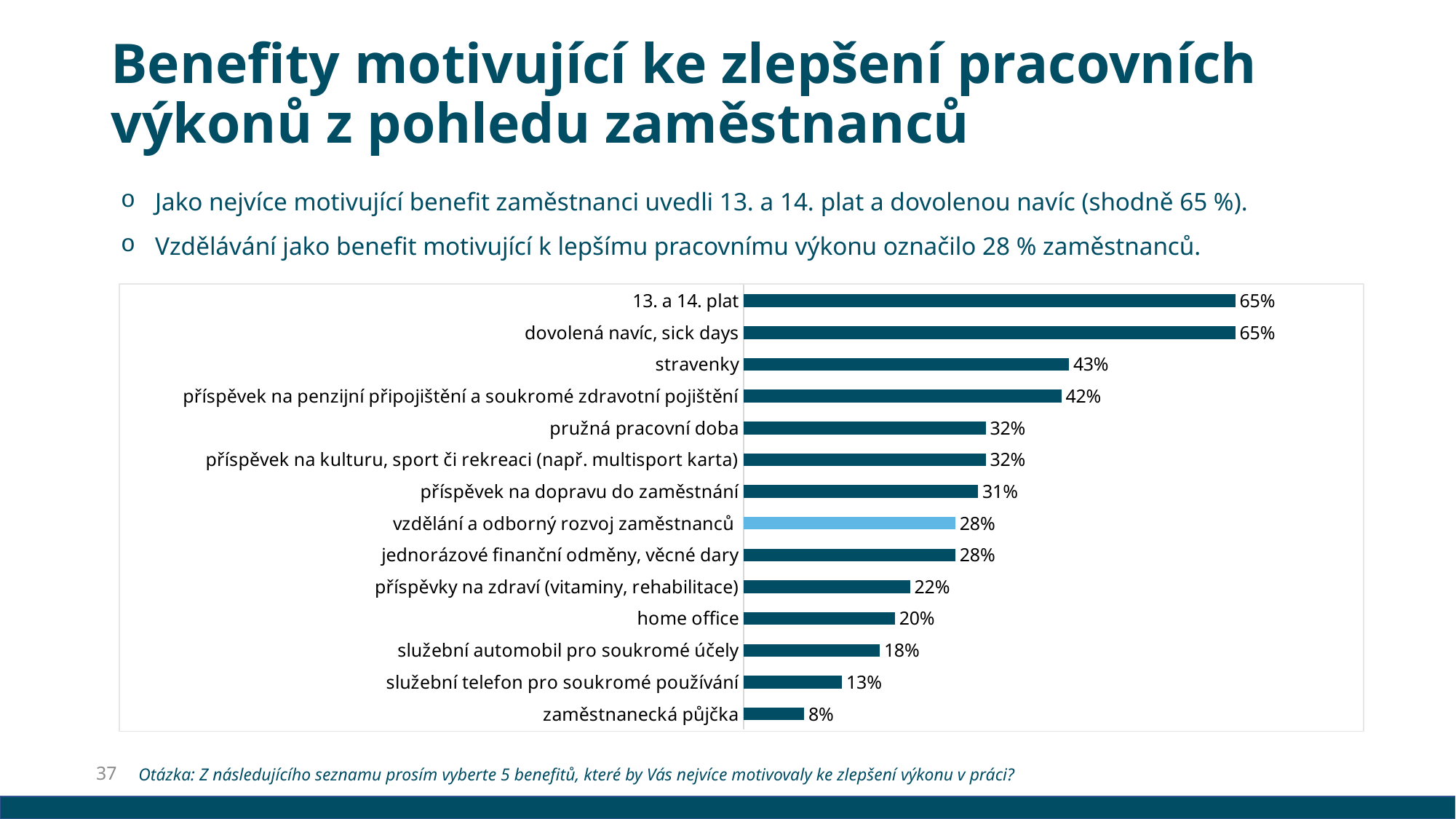
What is the highest value shown in the chart? 65% What is the value for "home office"? 20% What kind of chart is shown on the slide? bar chart Which bar is highlighted in a lighter blue colour than the others? vzdělání a odborný rozvoj zaměstnanců What is the value for "vzdělání a odborný rozvoj zaměstnanců"? 28% What is the value for "stravenky"? 43% What is the value for "služební telefon pro soukromé používání"? 13% What is the difference between the values for "stravenky" and "home office"? 23% Which is larger, the value for "příspěvek na dopravu do zaměstnání" or the value for "příspěvky na zdraví (vitaminy, rehabilitace)"? příspěvek na dopravu do zaměstnání Which category has the lowest value? zaměstnanecká půjčka How many categories are shown in the chart? 14 What is the difference between the values for "13. a 14. plat" and "zaměstnanecká půjčka"? 57%